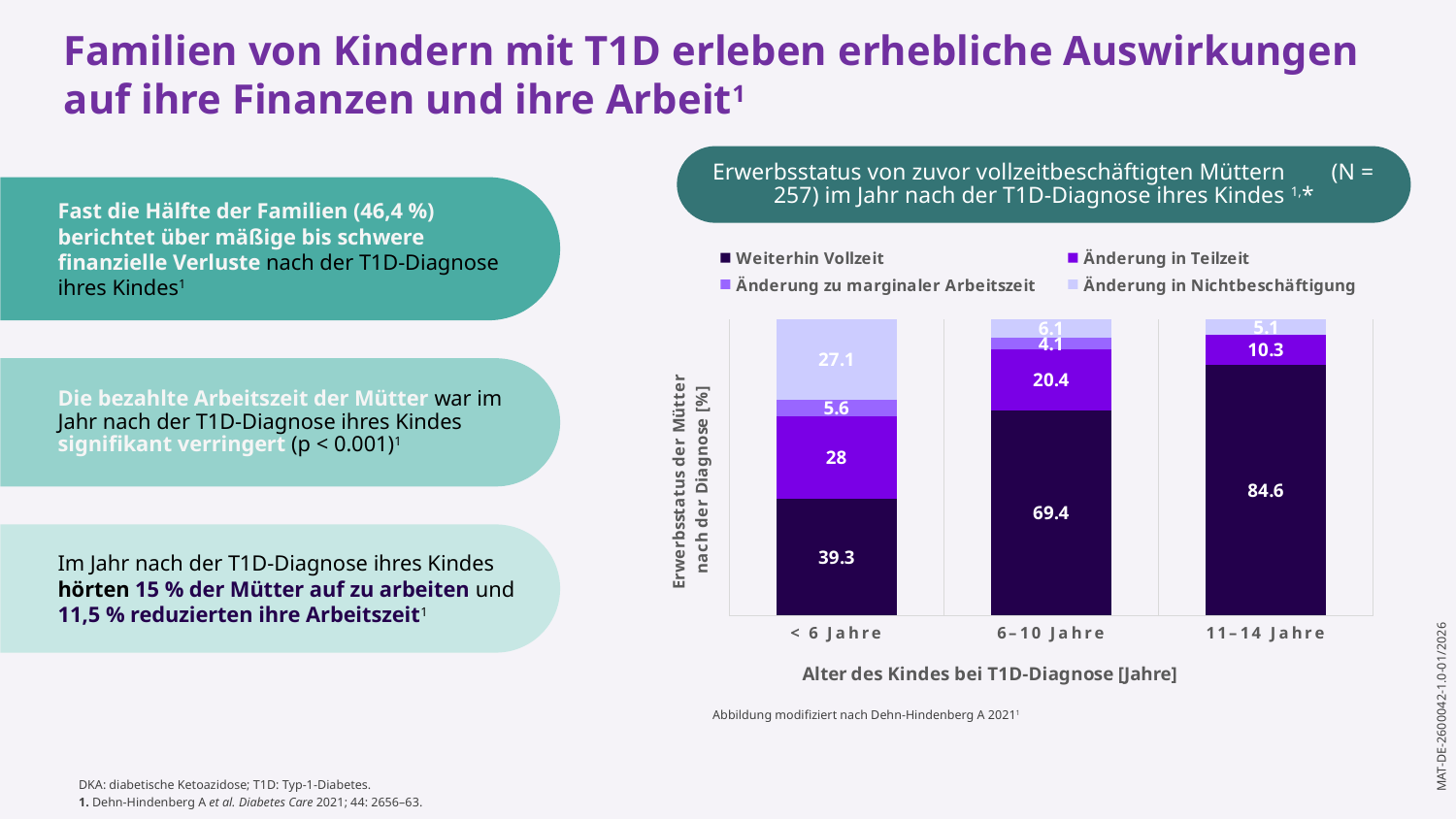
How many series does the chart legend list? 4 What is the label of the x axis of the chart? Alter des Kindes bei T1D-Diagnose [Jahre] What is the value for "Änderung in Nichtbeschäftigung" in the "< 6 Jahre" category? 27.1 What is the value for "Änderung in Teilzeit" in the "6–10 Jahre" category? 20.4 What kind of chart is shown on the slide? Stacked bar chart What is the value for "Weiterhin Vollzeit" in the "11–14 Jahre" category? 84.6 Which age category has the lowest value for "Änderung in Teilzeit"? 11–14 Jahre How many age categories are shown on the x axis of the chart? 3 What is the value for "Weiterhin Vollzeit" in the "< 6 Jahre" category? 39.3 Which age category has the highest value for "Weiterhin Vollzeit"? 11–14 Jahre Does the value for "Weiterhin Vollzeit" rise or fall as the age at diagnosis increases along the x axis? Rise What is the difference between the "Weiterhin Vollzeit" values for "11–14 Jahre" and "< 6 Jahre"? 45.3